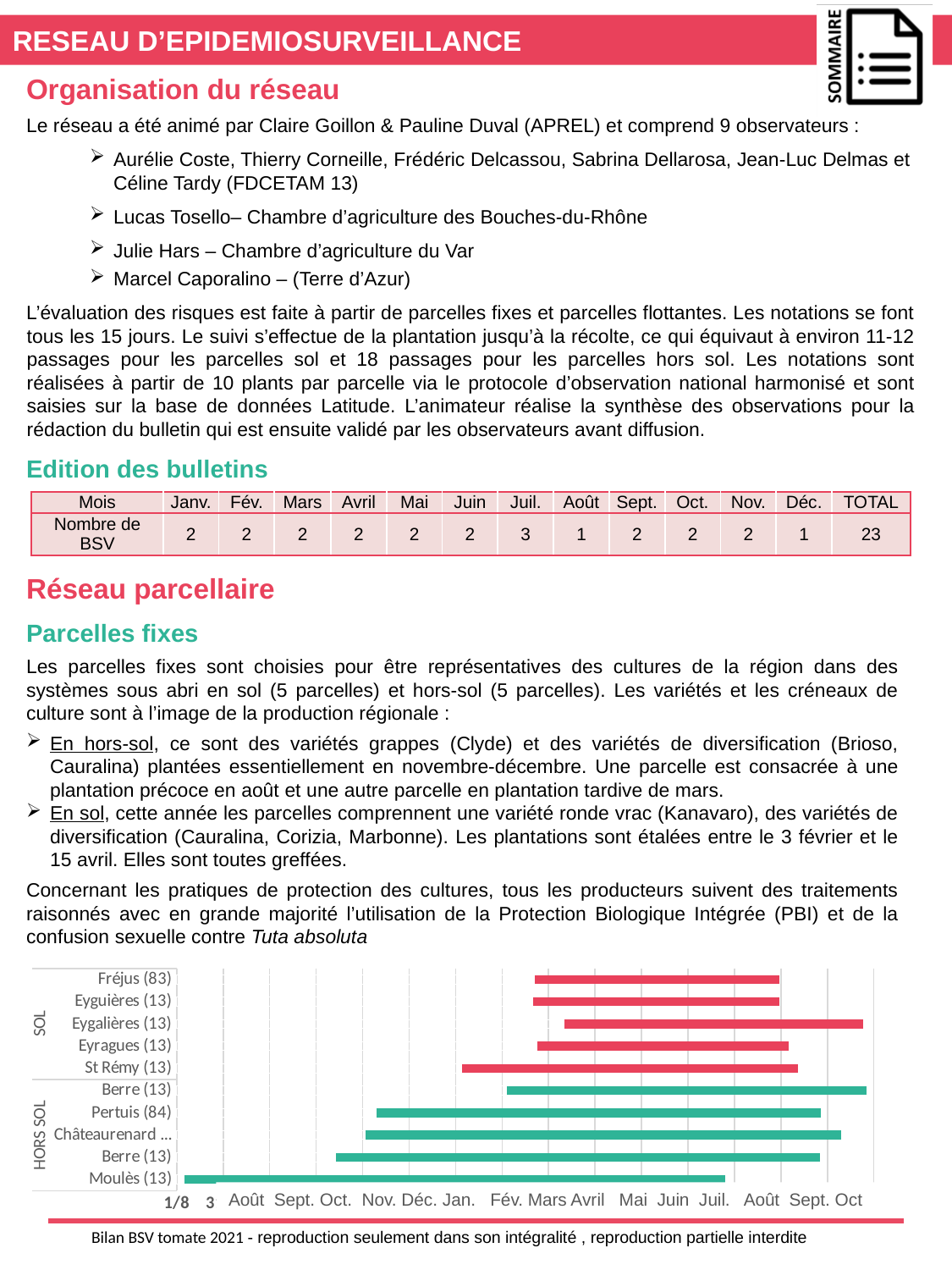
In the chart at the bottom of the slide, which parcel's bar starts earliest on the x axis? Moulès (13) In the chart at the bottom of the slide, which HORS SOL parcel's bar starts latest? Berre (13) How many parcels are grouped under HORS SOL in the chart at the bottom of the slide? 5 What colour are the bars for the HORS SOL parcels in the chart at the bottom of the slide? Teal (green) How many parcels (categories) are listed on the vertical axis of the chart at the bottom of the slide? 10 In the chart at the bottom of the slide, does the bar for Moulès (13) start before or after Sept.? Before In the chart at the bottom of the slide, which SOL parcel's bar starts earliest? St Rémy (13) What colour are the bars for the SOL parcels in the chart at the bottom of the slide? Red What kind of chart is shown at the bottom of the slide? Bar chart In the chart at the bottom of the slide, does the bar for Fréjus (83) start before or after Jan.? After How many parcels are grouped under SOL in the chart at the bottom of the slide? 5 In the chart at the bottom of the slide, which group has the longer bars overall, SOL or HORS SOL? HORS SOL